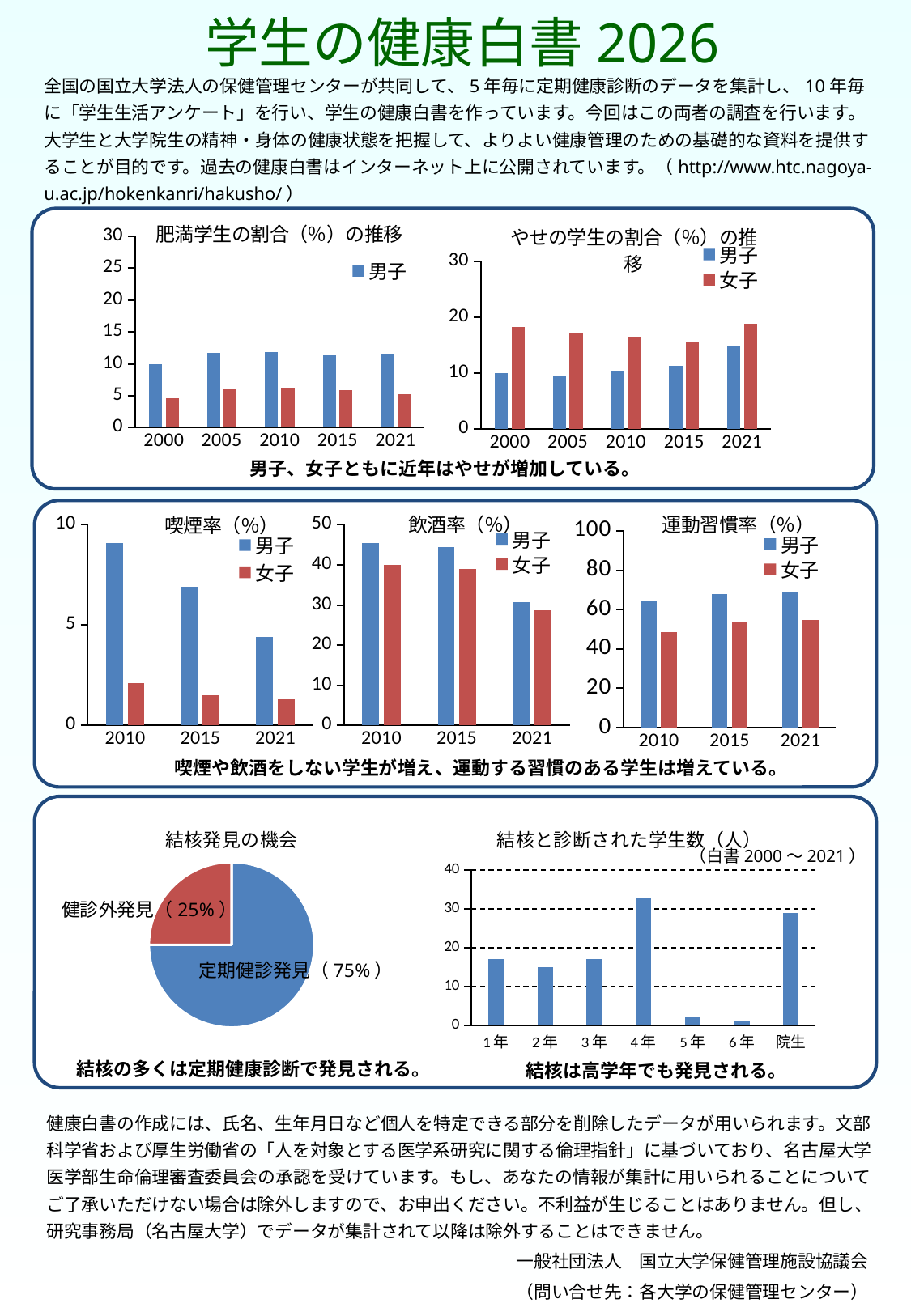
In the やせの学生の割合（%）の推移 chart, which is larger in 2000, 男子 or 女子? 女子 In the 結核と診断された学生数（人） chart, which category has the lowest value? 6年 In the 結核と診断された学生数（人） chart, is the value for 4年 greater or less than 30? greater In the 結核と診断された学生数（人） chart, which category has the highest value? 4年 In the 飲酒率（%） chart, is the 男子 value for 2010 greater or less than 40? greater What kind of chart is 結核発見の機会? pie chart In the 喫煙率（%） chart, how many series does the legend list? 2 In the 喫煙率（%） chart, do the 男子 values rise or fall from 2010 to 2021? fall In the 結核発見の機会 pie chart, what share is 定期健診発見? 75% In the 結核と診断された学生数（人） chart, how many categories are shown on the x axis? 7 In the 運動習慣率（%） chart, which is larger in 2010, 男子 or 女子? 男子 In the 結核発見の機会 pie chart, what share is 健診外発見? 25%